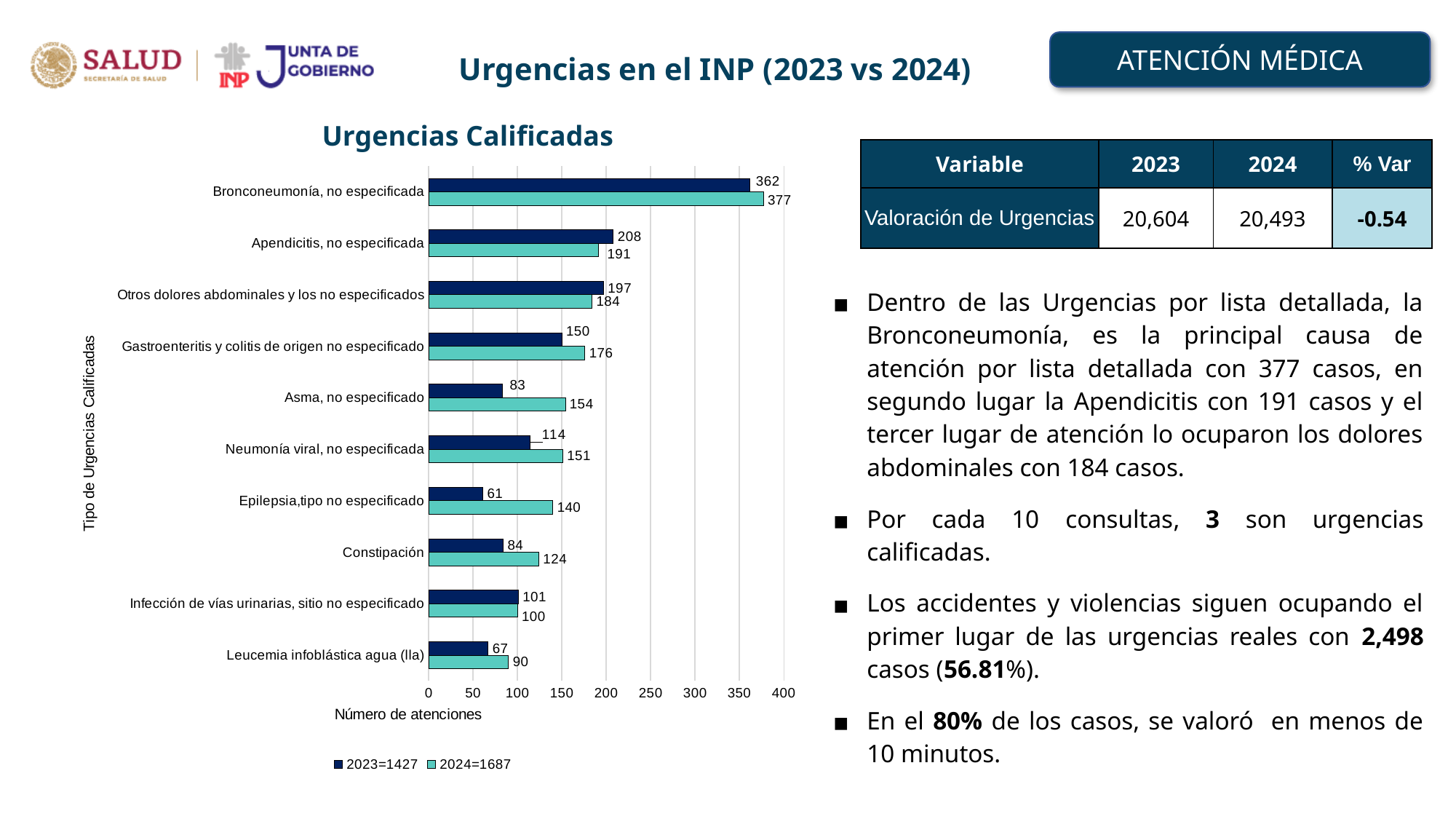
What type of chart is shown on the slide? Bar chart Is the 2023 value for Neumonía viral, no especificada greater or less than 100? greater What is the 2024 value for Epilepsia,tipo no especificado? 140 For Gastroenteritis y colitis de origen no especificado, which year has the larger value, 2023 or 2024? 2024 How many categories are shown on the y axis of the chart? 10 How many series does the chart legend list? 2 Which category has the highest 2024 value? Bronconeumonía, no especificada What is the 2024 value for Bronconeumonía, no especificada? 377 What is the title of the chart? Urgencias Calificadas What is the difference between the 2024 and 2023 values for Apendicitis, no especificada? 17 Which category has the lowest 2023 value? Epilepsia,tipo no especificado What is the 2023 value for Asma, no especificado? 83